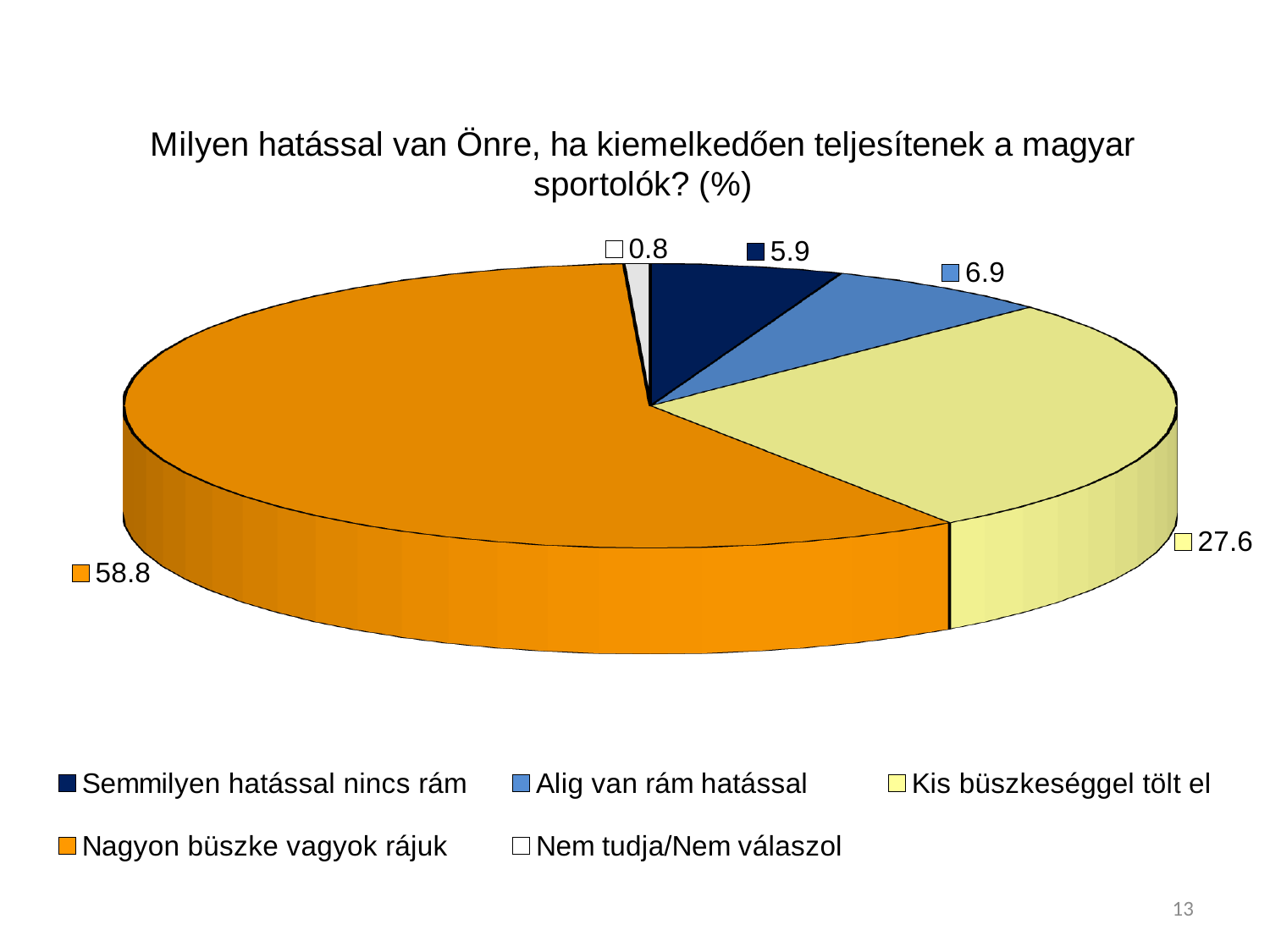
What is the difference between the values for "Nagyon büszke vagyok rájuk" and "Kis büszkeséggel tölt el"? 31.2 Which category has the largest slice of the pie? Nagyon büszke vagyok rájuk Which is larger, the value for "Alig van rám hatással" or the value for "Semmilyen hatással nincs rám"? Alig van rám hatással What is the value for "Alig van rám hatással"? 6.9 How many slices does the pie chart have? 5 What is the value for "Kis büszkeséggel tölt el"? 27.6 What is the title of the chart? Milyen hatással van Önre, ha kiemelkedően teljesítenek a magyar sportolók? (%) Which category has the smallest slice of the pie? Nem tudja/Nem válaszol What is the value for "Nem tudja/Nem válaszol"? 0.8 What kind of chart is shown on the slide? Pie chart What is the value for "Semmilyen hatással nincs rám"? 5.9 What is the value for "Nagyon büszke vagyok rájuk"? 58.8